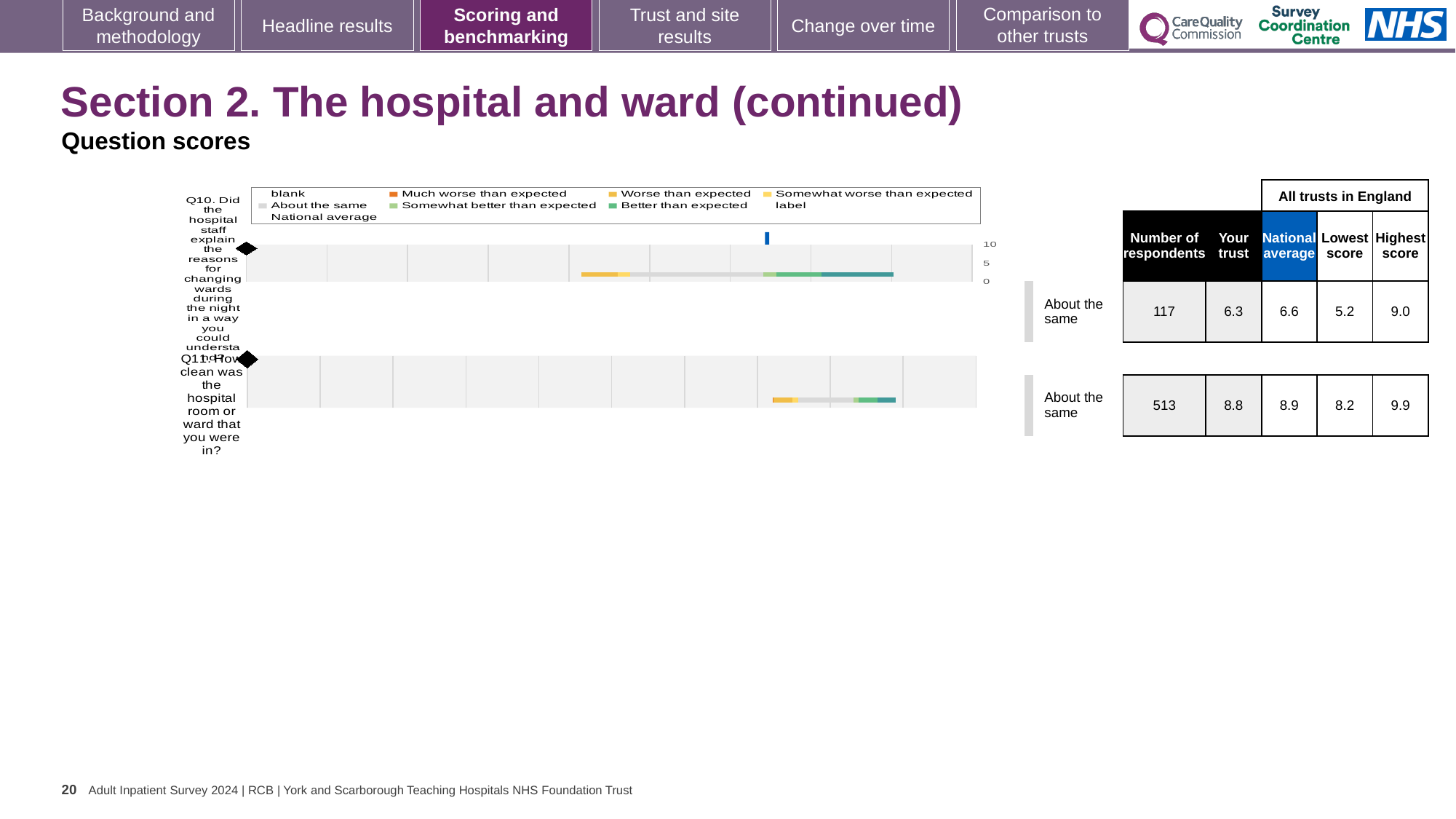
What is the lowest score among all trusts in England for Q10, as shown beside the chart? 5.2 What is the difference between the national average and the trust score for Q10? 0.3 What benchmark category is given for the trust's Q10 score? About the same What kind of chart is used to show the question scores for Q10 and Q11? bar chart How many respondents answered Q11, as shown in the table beside its chart? 513 How many survey questions are plotted on the slide? 2 According to the table next to the Q10 chart, what is the trust's score for Q10? 6.3 What is the highest value shown on the score axis of the Q10 chart? 10 What is the difference between the highest and lowest scores for Q11? 1.7 Which question has the higher trust score, Q10 or Q11? Q11 What is the highest score among all trusts in England for Q11, as shown beside the chart? 9.9 According to the table next to the Q11 chart, what is the national average for Q11? 8.9